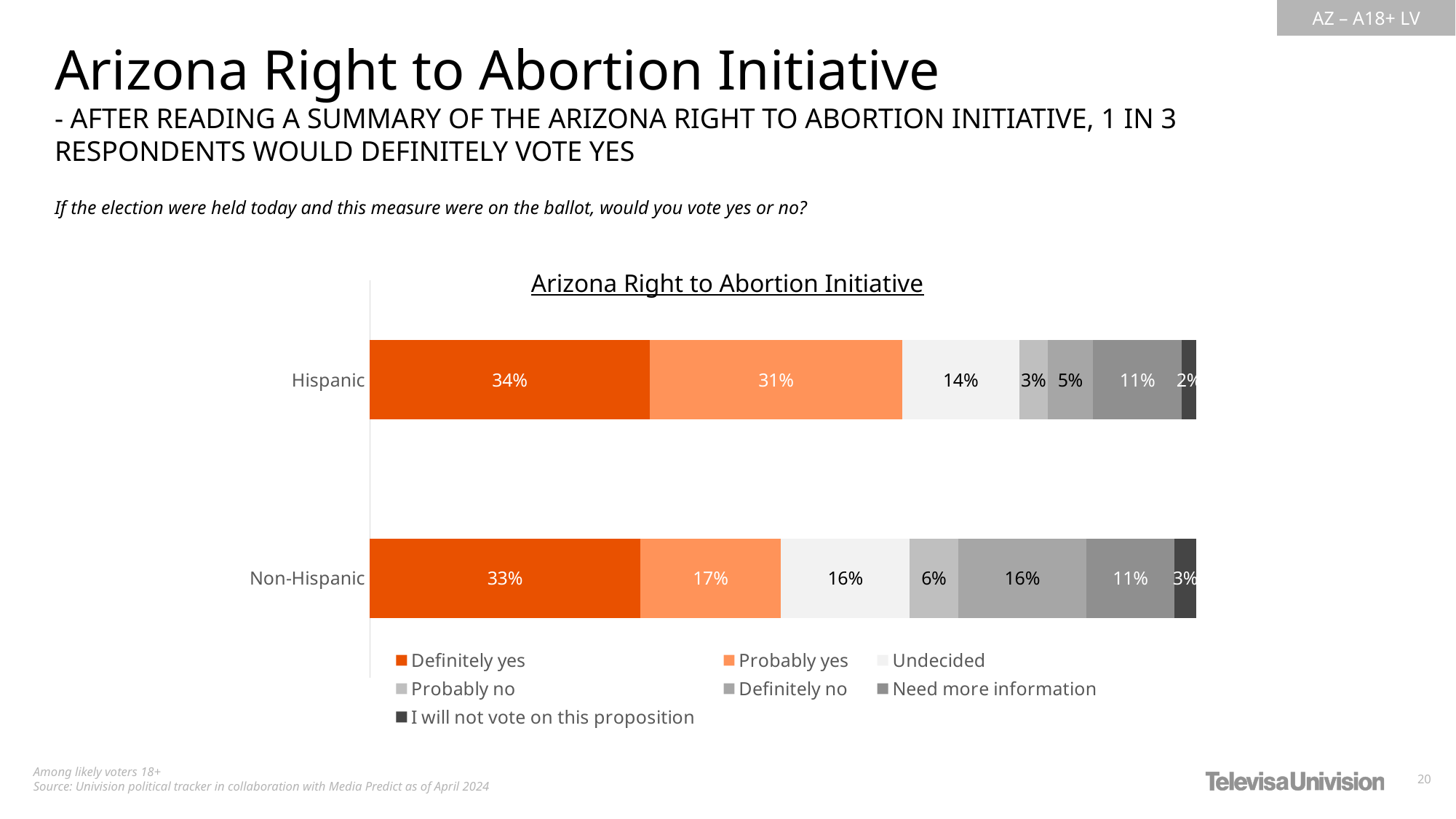
What is the title of the chart? Arizona Right to Abortion Initiative What percentage of Hispanic respondents said 'Definitely yes'? 34% What is the 'Undecided' value for Non-Hispanic respondents? 16% Which response category has the highest value for Hispanic respondents? Definitely yes Which group has the larger 'Definitely no' share, Hispanic or Non-Hispanic? Non-Hispanic How many series does the legend list? 7 What percentage of Non-Hispanic respondents said 'Probably yes'? 17% How many categories are plotted on the chart? 2 Which response category has the lowest value for Non-Hispanic respondents? I will not vote on this proposition What is the difference between the 'Probably yes' values for Hispanic and Non-Hispanic respondents? 14% What is the 'Need more information' value for Hispanic respondents? 11% What kind of chart is shown on the slide? Stacked bar chart